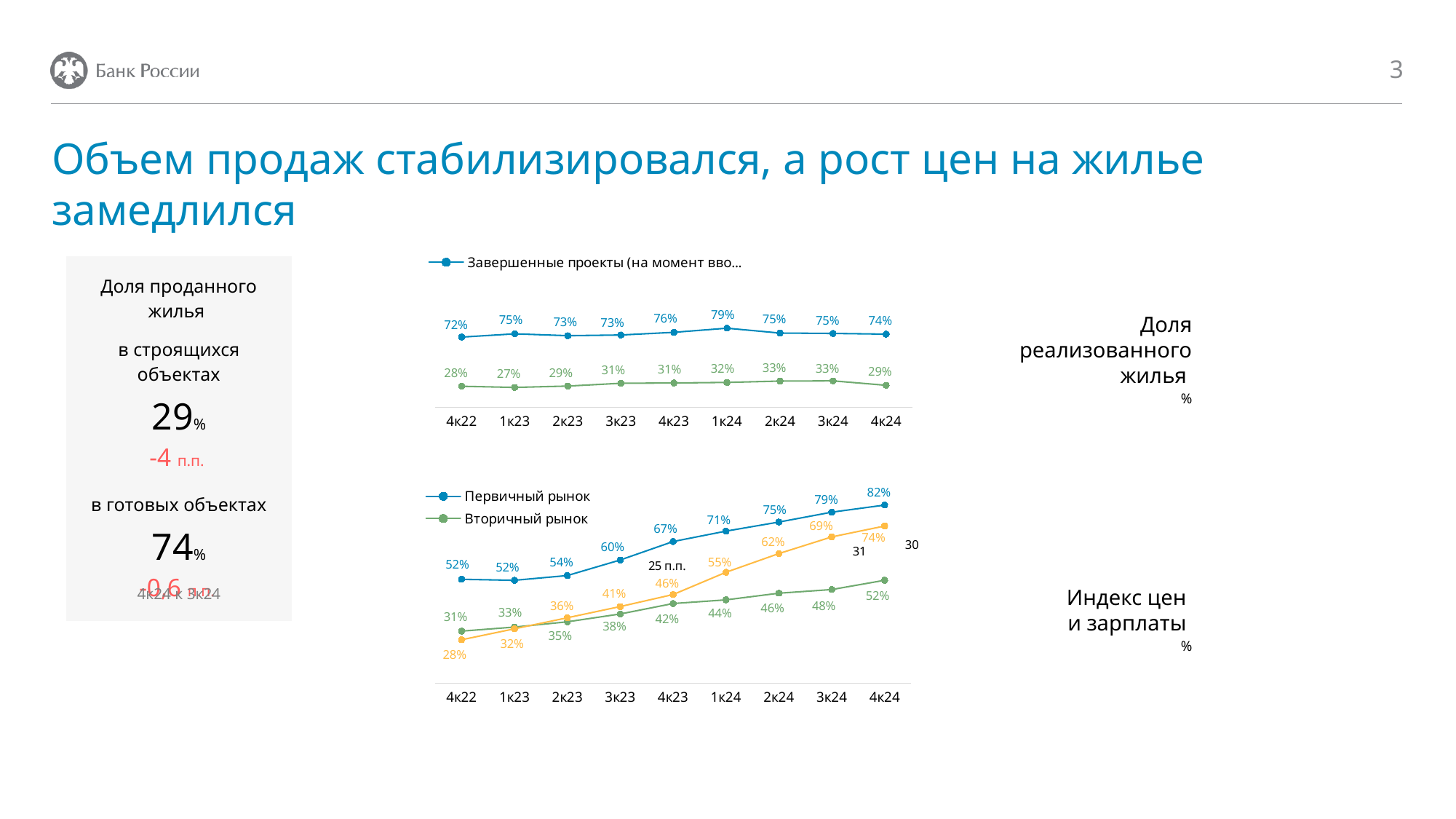
In the top chart (Доля реализованного жилья), how many quarters are shown on the x axis? 9 What type of chart is the bottom chart (Индекс цен и зарплаты)? Line chart In the bottom chart (Индекс цен и зарплаты), what is the difference between Первичный рынок and Вторичный рынок at 4к24? 30 п.п. In the bottom chart (Индекс цен и зарплаты), which is larger at 3к23: Первичный рынок or Вторичный рынок? Первичный рынок In the top chart (Доля реализованного жилья), at which quarter does the Завершенные проекты series reach its highest value? 1к24 In the top chart (Доля реализованного жилья), what is the difference between the Завершенные проекты values at 4к24 and 4к22? 2 п.п. In the bottom chart (Индекс цен и зарплаты), does the Первичный рынок series rise or fall from 4к22 to 4к24? Rises How many series does the legend of the bottom chart (Индекс цен и зарплаты) list? 2 In the bottom chart (Индекс цен и зарплаты), what is the value of Первичный рынок at 4к24? 82% In the bottom chart (Индекс цен и зарплаты), what is the value of Вторичный рынок at 4к22? 31% In the top chart (Доля реализованного жилья), at which quarter is the green series at its lowest value? 1к23 In the top chart (Доля реализованного жилья), what is the value of the Завершенные проекты series at 1к24? 79%